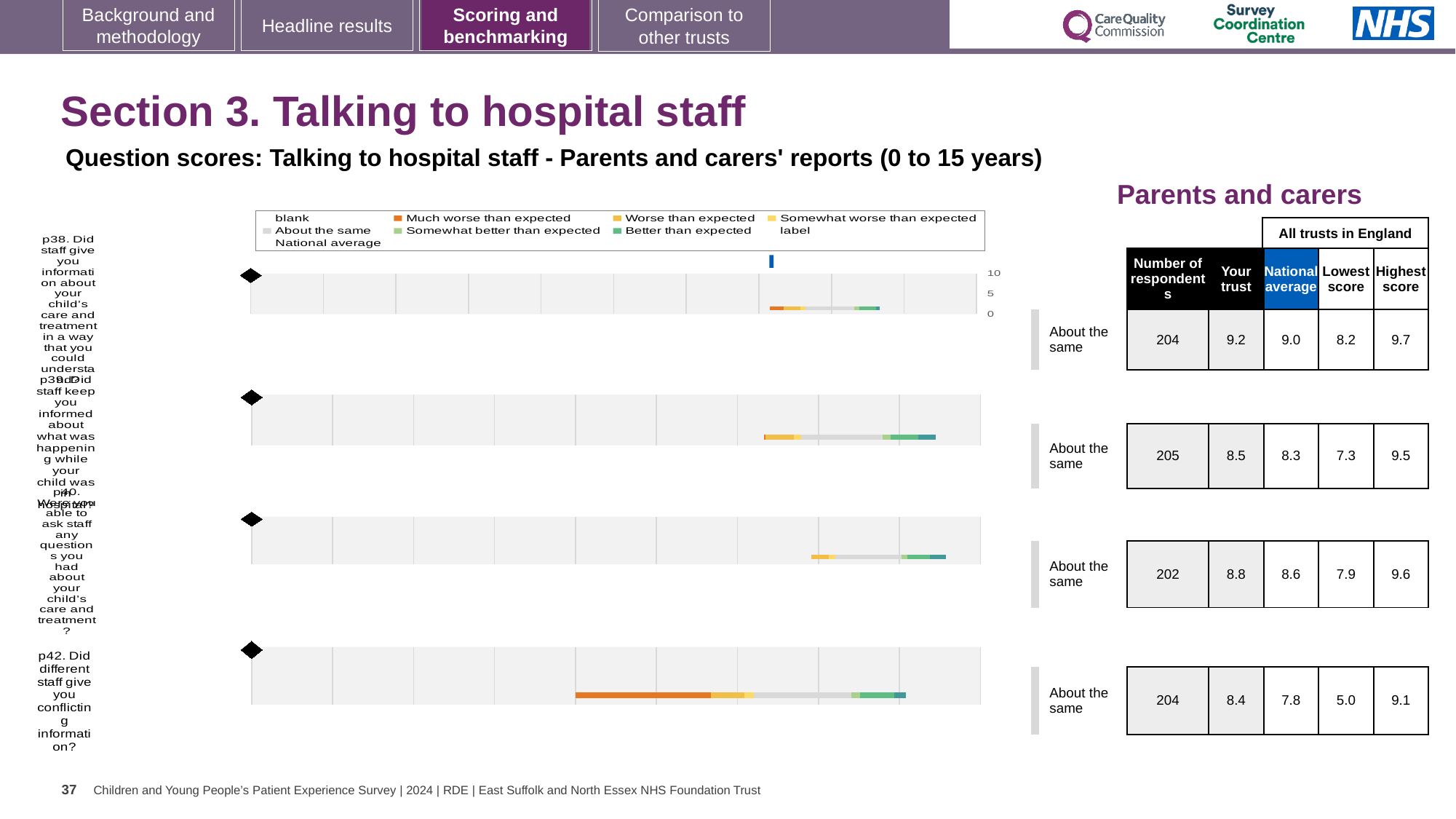
How many respondents answered p39 (Did staff keep you informed about what was happening while your child was in hospital)? 205 For p38, how much higher is the 'Your trust' score than the National average? 0.2 Which question has the lowest 'Your trust' score on this slide? p42 What benchmark label is shown next to the chart for p40? About the same How many survey questions (p38, p39, p40, p42) have a chart on this slide? 4 For p42, what is the difference between the Highest score and the Lowest score across all trusts in England? 4.1 For p40, which is larger: the 'Your trust' score or the National average? Your trust What kind of chart is used to show the question scores on this slide? bar chart What is the 'Your trust' score for p38 (Did staff give you information about your child's care and treatment in a way that you could understand)? 9.2 What is the National average score for p42 (Did different staff give you conflicting information)? 7.8 Which question has the highest 'Your trust' score on this slide? p38 What is the Lowest score among all trusts in England for p42? 5.0